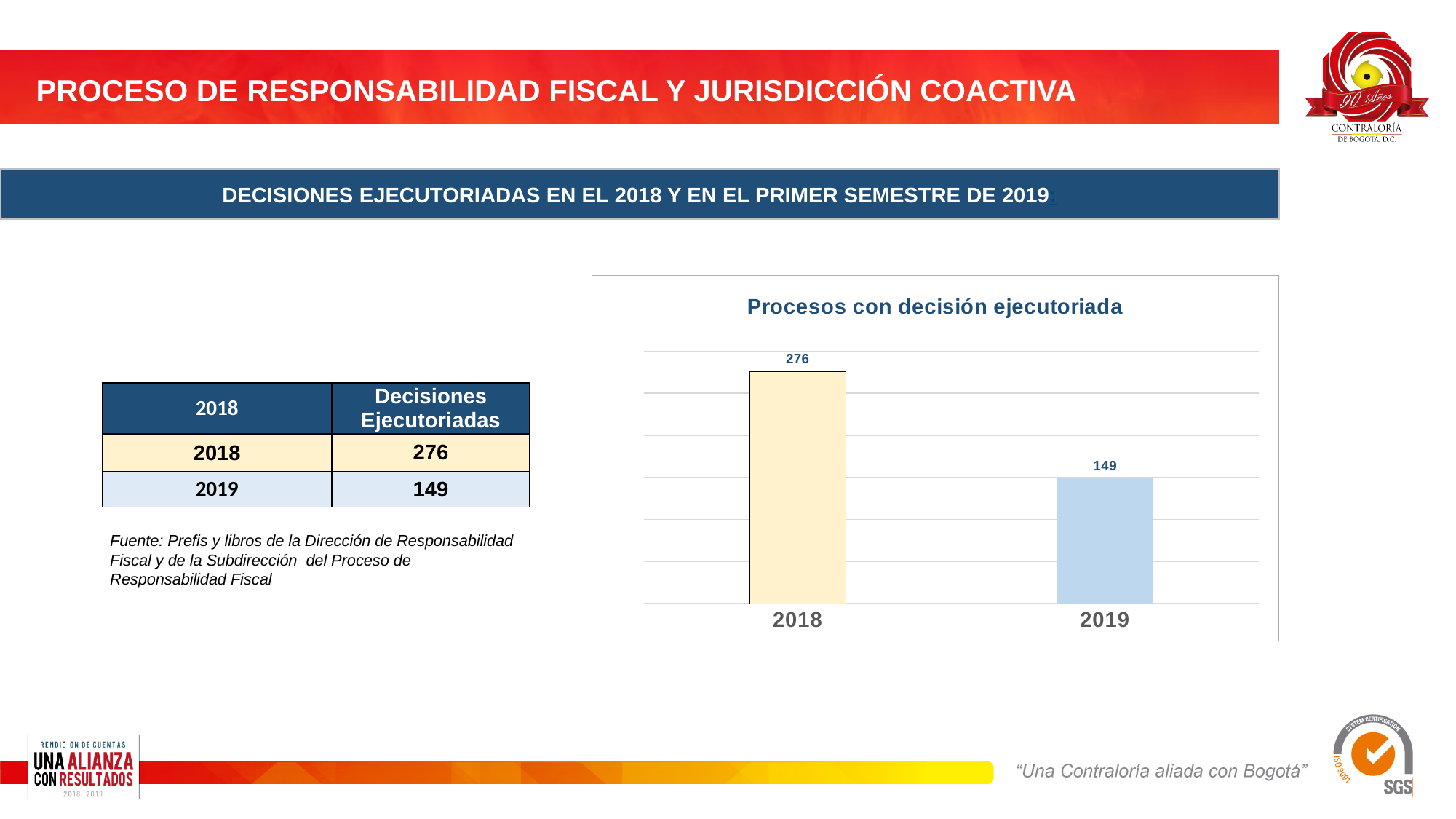
Which year has the lowest value in the chart? 2019 What is the difference between the values for 2018 and 2019? 127 What is the value for 2018 in the chart? 276 What is the title of the chart? Procesos con decisión ejecutoriada What is the value for 2019 in the chart? 149 Which year has the highest value in the chart? 2018 How many bars are shown in the chart? 2 What kind of chart is shown on the slide? Bar chart Do the values rise or fall from 2018 to 2019? Fall What colour is the bar for 2019? Light blue Which is larger, the value for 2018 or the value for 2019? 2018